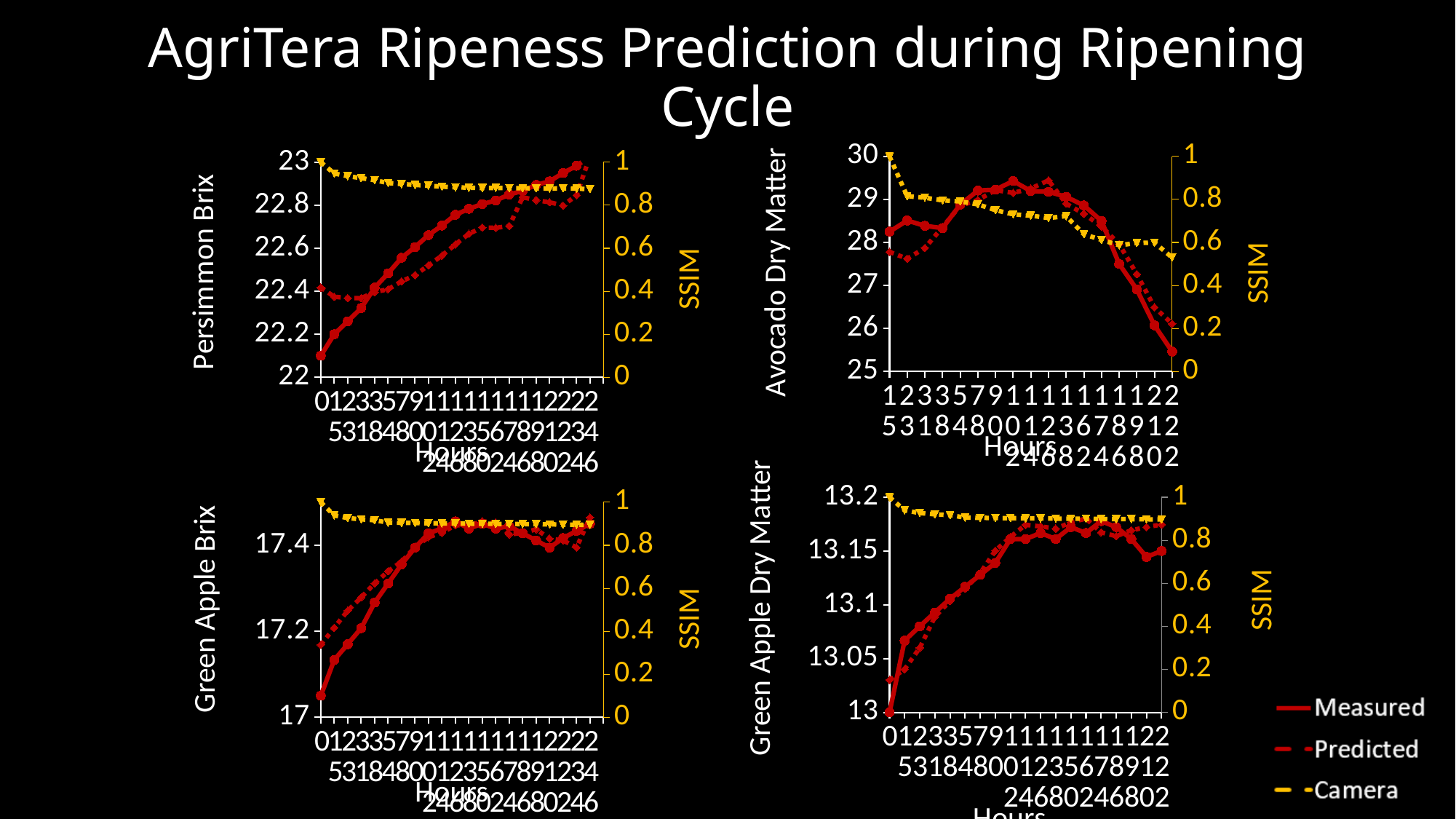
Which series in the legend is drawn with a yellow dashed line? Camera In the Avocado Dry Matter chart, is the Measured value at the last point higher or lower than at the first point? lower How many charts are shown on the slide? 4 In the Avocado Dry Matter chart, is the Measured value at the last point greater or less than 26? less In the Green Apple Brix chart, is the Measured value at the first point greater or less than 17.2? less In the Persimmon Brix chart, is the Measured value at the first point greater or less than 22.4? less What kind of chart is the Persimmon Brix chart? line chart What is the label of the right-hand vertical axis on each chart? SSIM In the Persimmon Brix chart, does the Measured line rise or fall along the x axis? rise How many series does the legend list? 3 In the Persimmon Brix chart, does the Camera SSIM line rise or fall along the x axis? fall